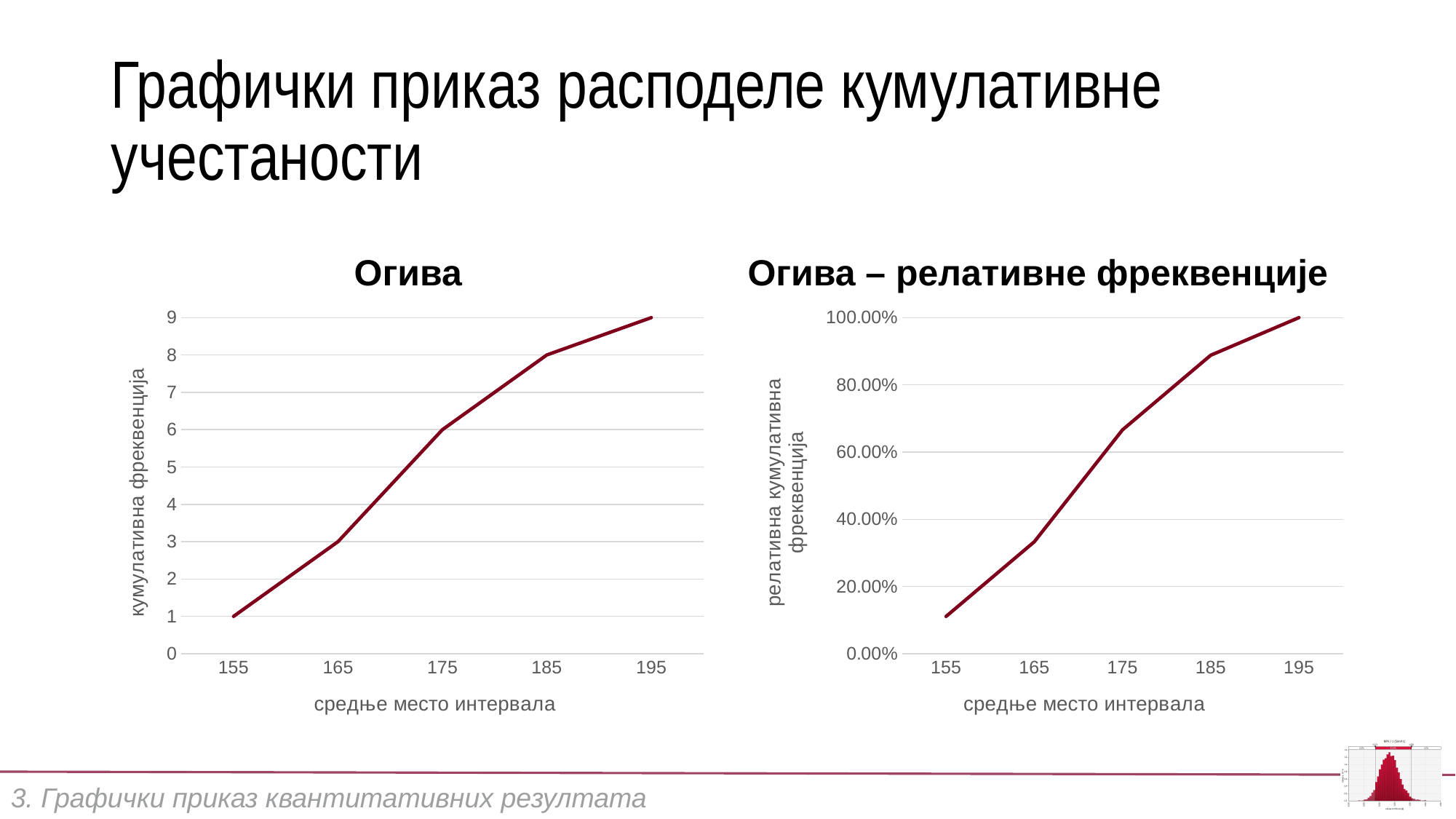
In the chart titled "Огива", which x-axis category has the lowest cumulative frequency? 155 In the chart titled "Огива – релативне фреквенције", is the value at 165 greater or less than 40.00%? less In the chart titled "Огива – релативне фреквенције", what is the relative cumulative frequency at 195? 100.00% In the chart titled "Огива", what is the cumulative frequency at 195? 9 In the chart titled "Огива", what is the cumulative frequency at 155? 1 In the chart titled "Огива", what is the difference between the values at 185 and 155? 7 What kind of chart is the chart titled "Огива"? line chart In the chart titled "Огива", what is the cumulative frequency at 175? 6 In the chart titled "Огива – релативне фреквенције", is the value at 175 greater or less than 60.00%? greater In the chart titled "Огива – релативне фреквенције", how many data points are plotted along the x axis? 5 In the chart titled "Огива – релативне фреквенције", is the value at 155 greater or less than 20.00%? less In the chart titled "Огива", which x-axis category has the highest cumulative frequency? 195